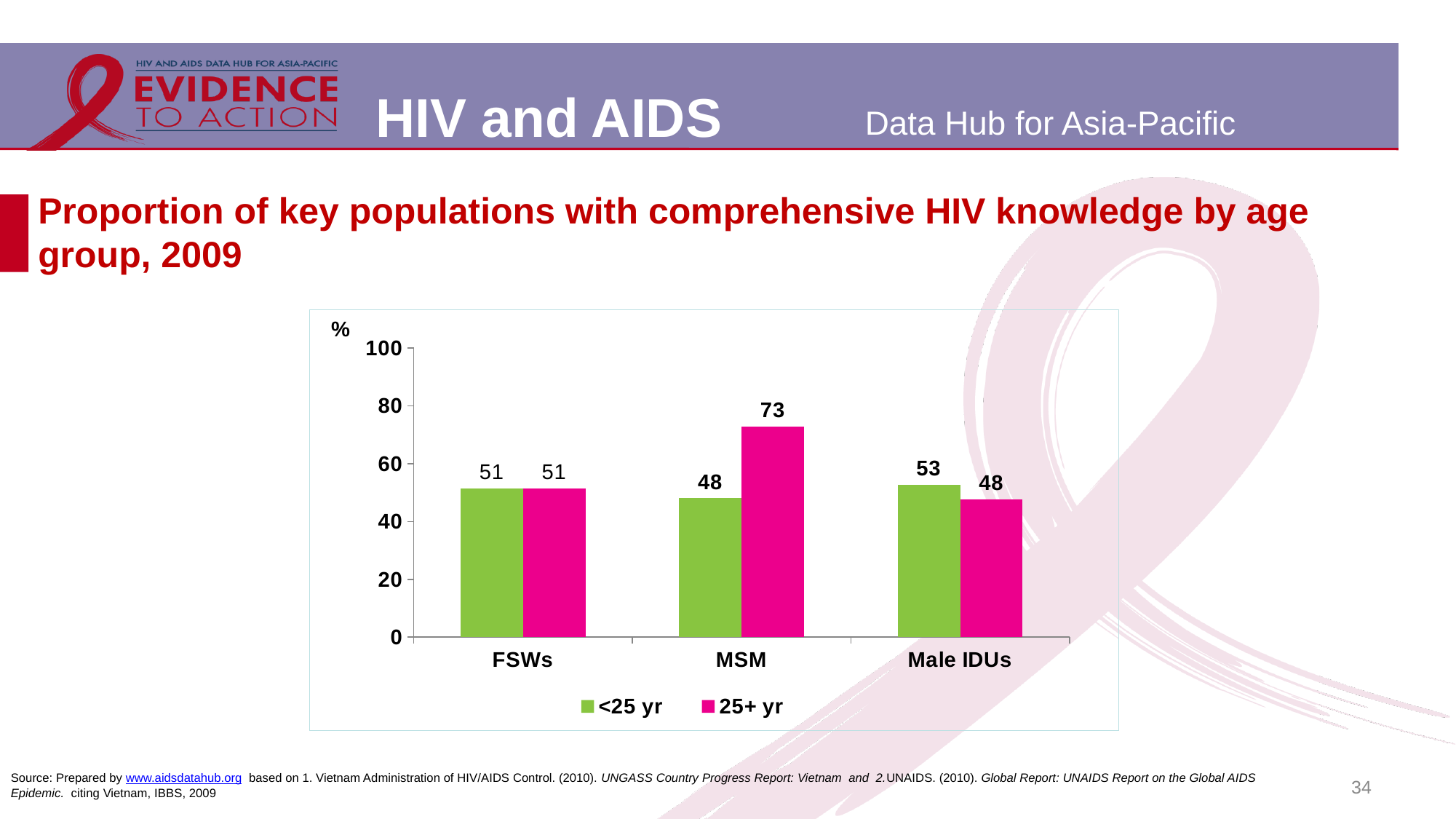
What kind of chart is shown on the slide? bar chart Is the value for MSM in the 25+ yr series greater or less than 60? greater What is the value for Male IDUs in the <25 yr series? 53 What is the value for FSWs in the 25+ yr series? 51 How many categories are shown on the x axis? 3 What is the difference between the <25 yr and 25+ yr values for Male IDUs? 5 Which category has the lowest value in the <25 yr series? MSM Which category has the highest value in the 25+ yr series? MSM How many series does the legend list? 2 Which is larger for Male IDUs: the <25 yr value or the 25+ yr value? <25 yr What is the difference between the 25+ yr and <25 yr values for MSM? 25 What is the value for MSM in the 25+ yr series? 73